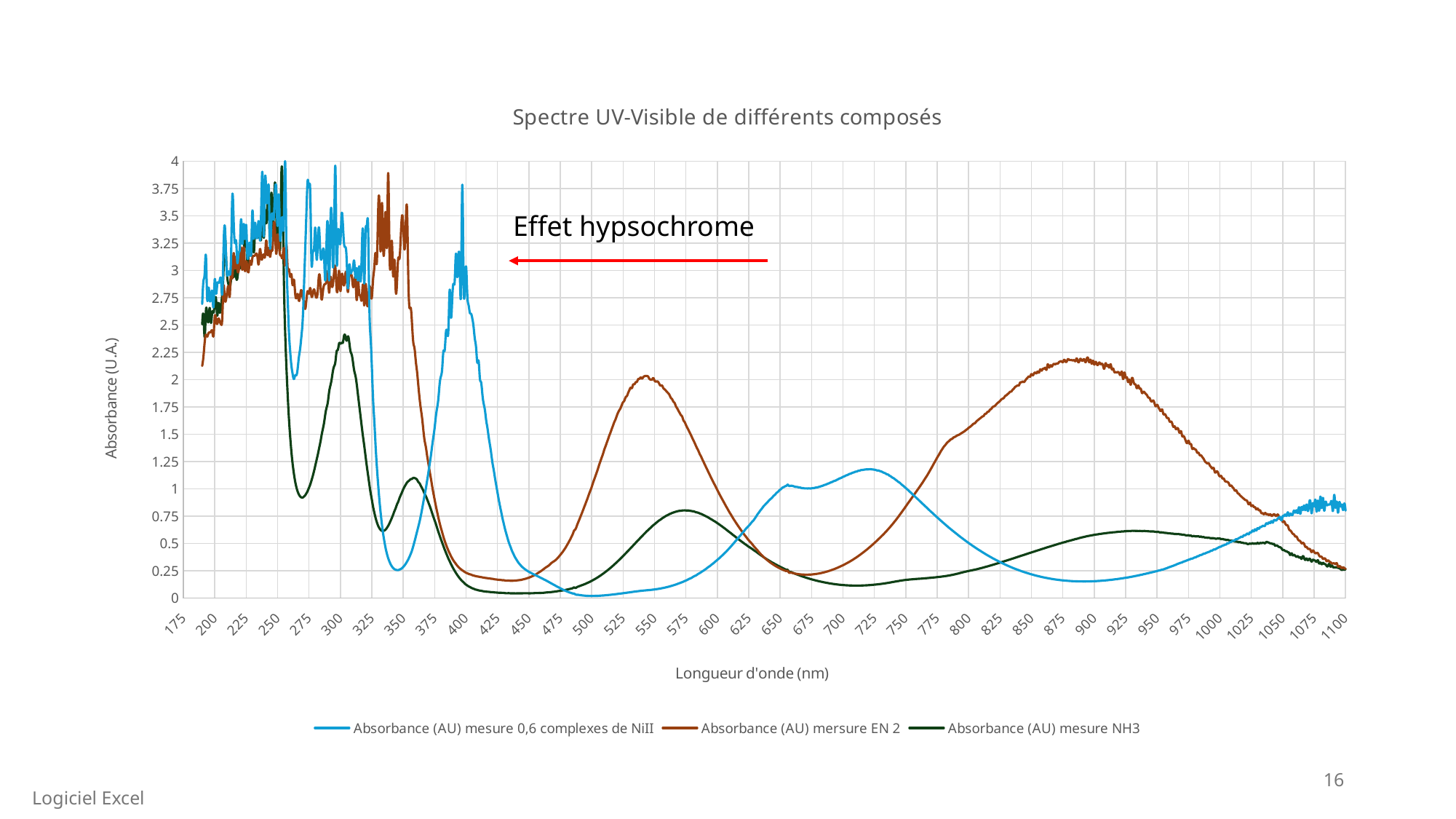
What is the label of the x axis? Longueur d'onde (nm) What kind of chart is shown on the slide? line chart How many series does the legend list? 3 What is the title of the chart? Spectre UV-Visible de différents composés Is the value of the series "Absorbance (AU) mesure NH3" at 575 nm greater or less than 1? less Is the value of the series "Absorbance (AU) mesure 0,6 complexes de NiII" at 500 nm greater or less than 0.5? less Between 900 nm and 1100 nm, does the series "Absorbance (AU) mersure EN 2" rise or fall? fall At 725 nm, which series has the higher absorbance: "Absorbance (AU) mesure 0,6 complexes de NiII" or "Absorbance (AU) mersure EN 2"? Absorbance (AU) mesure 0,6 complexes de NiII Is the value of the series "Absorbance (AU) mersure EN 2" at 550 nm greater or less than 1.5? greater At 550 nm, which series has the higher absorbance: "Absorbance (AU) mersure EN 2" or "Absorbance (AU) mesure NH3"? Absorbance (AU) mersure EN 2